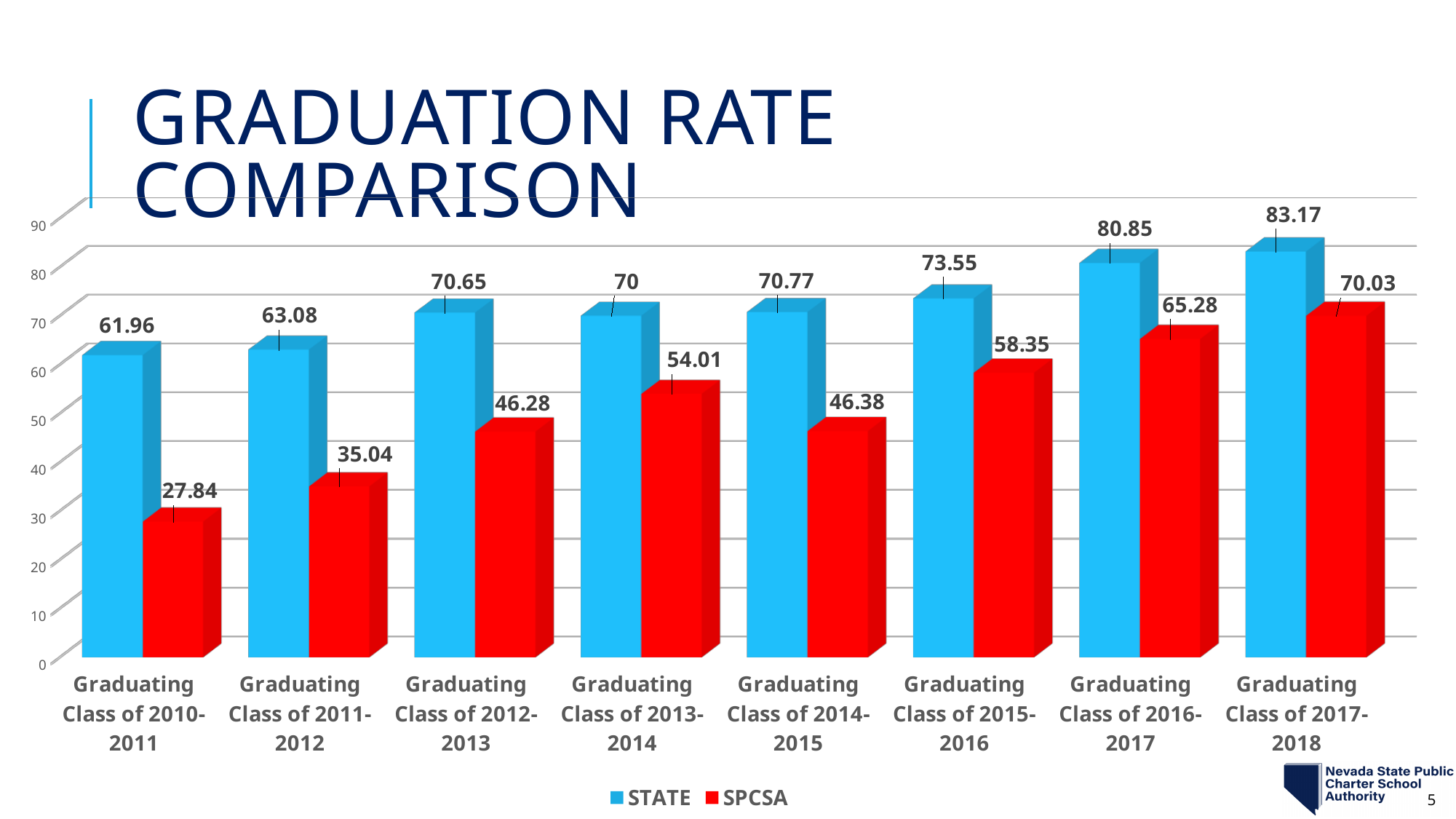
How many graduating classes are shown on the x axis? 8 What is the difference between the STATE and SPCSA values for the Graduating Class of 2016-2017? 15.57 What is the STATE graduation rate for the Graduating Class of 2010-2011? 61.96 Which graduating class has the lowest SPCSA graduation rate? Graduating Class of 2010-2011 What is the title of the chart? Graduation Rate Comparison Which graduating class has the highest STATE graduation rate? Graduating Class of 2017-2018 What is the SPCSA graduation rate for the Graduating Class of 2015-2016? 58.35 What is the SPCSA value for the Graduating Class of 2017-2018? 70.03 Do the SPCSA values generally rise or fall from the Graduating Class of 2014-2015 to the Graduating Class of 2017-2018? Rise What kind of chart is shown on the slide? Bar chart How many series does the legend list? 2 Which is larger for the Graduating Class of 2013-2014: the STATE value or the SPCSA value? STATE